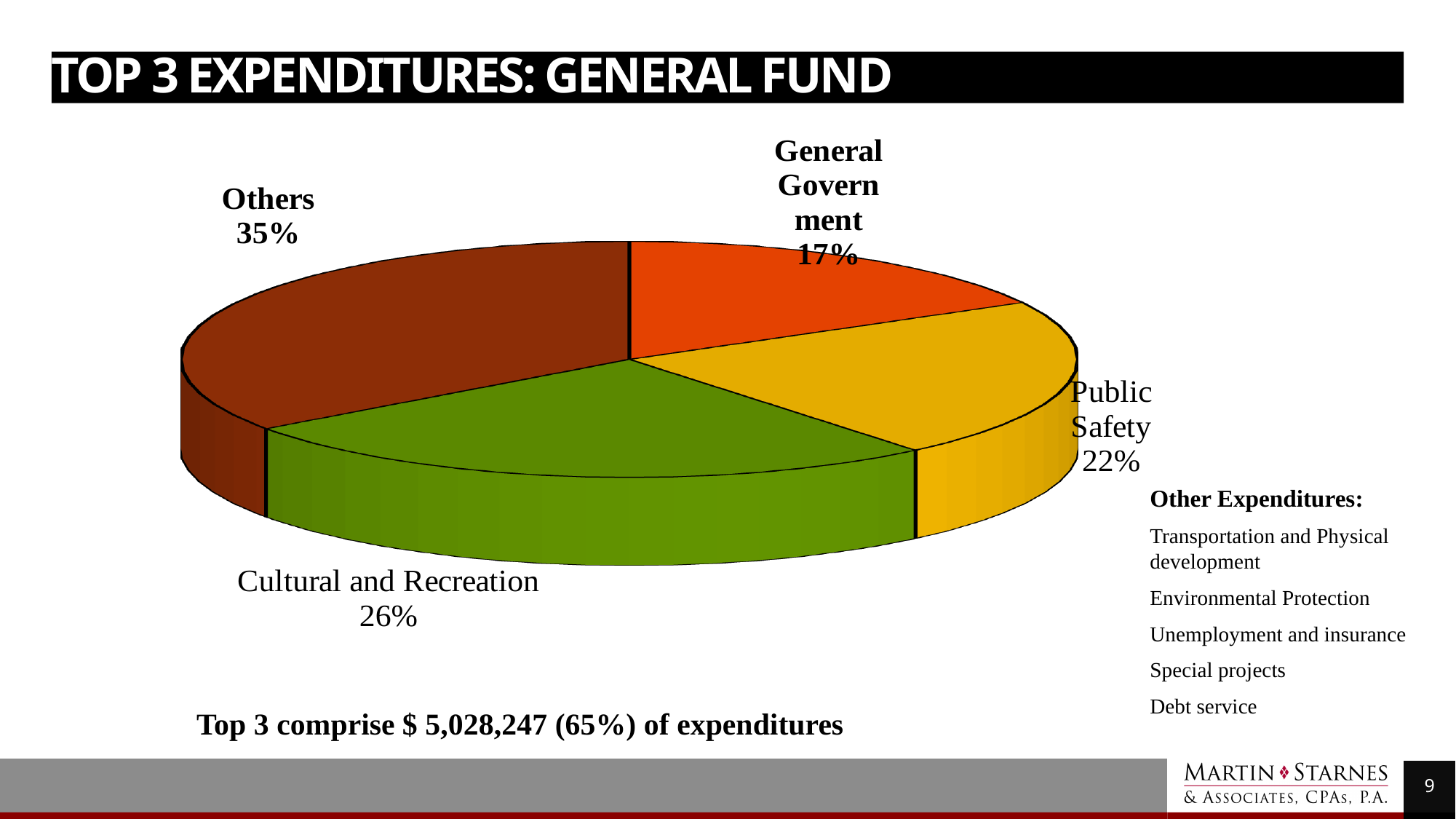
Which slice of the pie is the smallest? General Government How many slices does the pie chart have? 4 What share of the pie does Public Safety represent? 22% What is the title of the slide containing the chart? TOP 3 EXPENDITURES: GENERAL FUND What kind of chart is shown on the slide? Pie chart What share of the pie does Cultural and Recreation represent? 26% What is the difference in percentage points between Others and General Government? 18 What is the difference in percentage points between Cultural and Recreation and Public Safety? 4 Which is larger, Public Safety or Cultural and Recreation? Cultural and Recreation Which slice of the pie is the largest? Others What share of the pie does General Government represent? 17% What share of the pie does Others represent? 35%